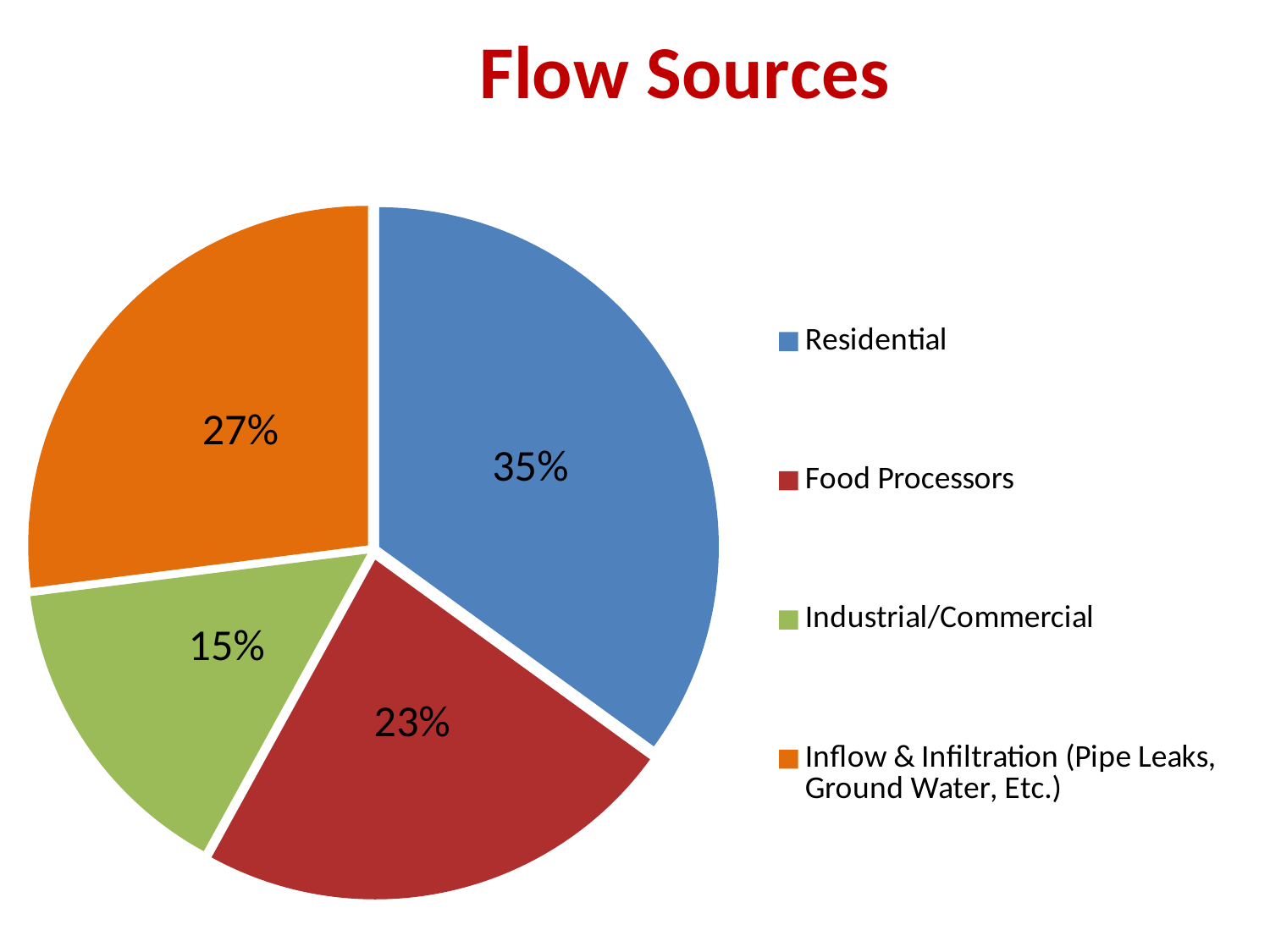
What is the difference in percentage points between the Inflow & Infiltration and Industrial/Commercial shares? 12 What is the difference in percentage points between the Residential and Food Processors shares? 12 What share of flow sources is Industrial/Commercial? 15% What is the title of the chart? Flow Sources What share of flow sources is Food Processors? 23% How many slices does the pie chart have? 4 What share of flow sources is Residential? 35% Which flow source has the smallest share? Industrial/Commercial What kind of chart is shown on the slide? Pie chart Which is larger, the Food Processors share or the Inflow & Infiltration share? Inflow & Infiltration Which flow source has the largest share? Residential